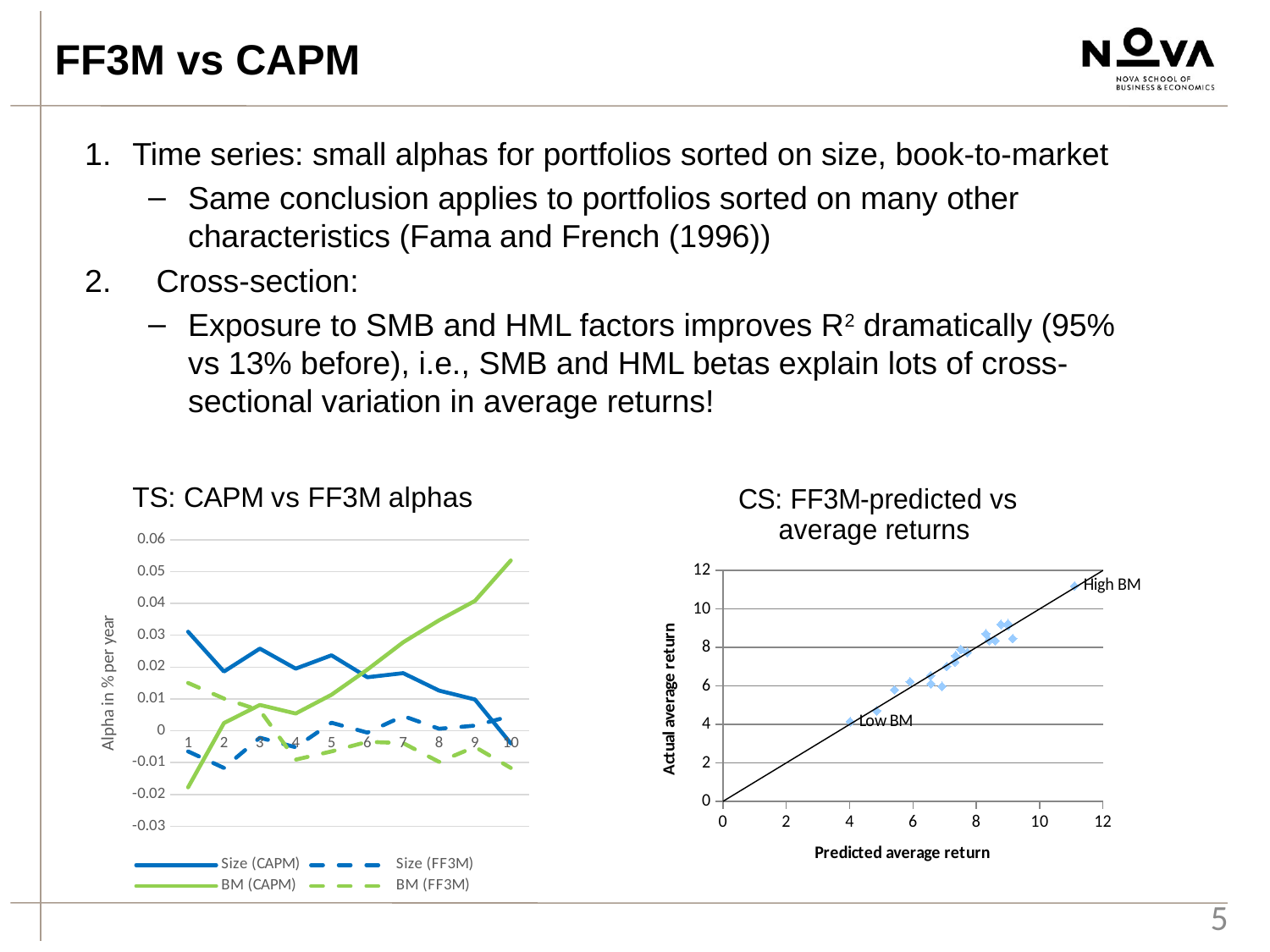
In the chart titled 'TS: CAPM vs FF3M alphas', is the BM (CAPM) value at portfolio 10 greater or less than 0.05? greater In the chart titled 'TS: CAPM vs FF3M alphas', how many series does the legend list? 4 In the chart titled 'TS: CAPM vs FF3M alphas', is the Size (CAPM) value at portfolio 1 greater or less than 0.02? greater In the chart titled 'TS: CAPM vs FF3M alphas', how many portfolios are plotted along the x axis? 10 In the chart titled 'CS: FF3M-predicted vs average returns', is the actual average return of the point labelled 'Low BM' greater or less than 6? less In the chart titled 'TS: CAPM vs FF3M alphas', at which portfolio is the BM (CAPM) alpha highest? 10 In the chart titled 'TS: CAPM vs FF3M alphas', at portfolio 1, which is larger: Size (CAPM) or BM (CAPM)? Size (CAPM) In the chart titled 'TS: CAPM vs FF3M alphas', does the Size (CAPM) line rise or fall from portfolio 1 to portfolio 10? fall In the chart titled 'TS: CAPM vs FF3M alphas', does the BM (CAPM) line rise or fall from portfolio 1 to portfolio 10? rise In the chart titled 'CS: FF3M-predicted vs average returns', what is the title of the x axis? Predicted average return In the chart titled 'CS: FF3M-predicted vs average returns', what kind of chart is shown? scatter chart In the chart titled 'TS: CAPM vs FF3M alphas', what kind of chart is shown? line chart